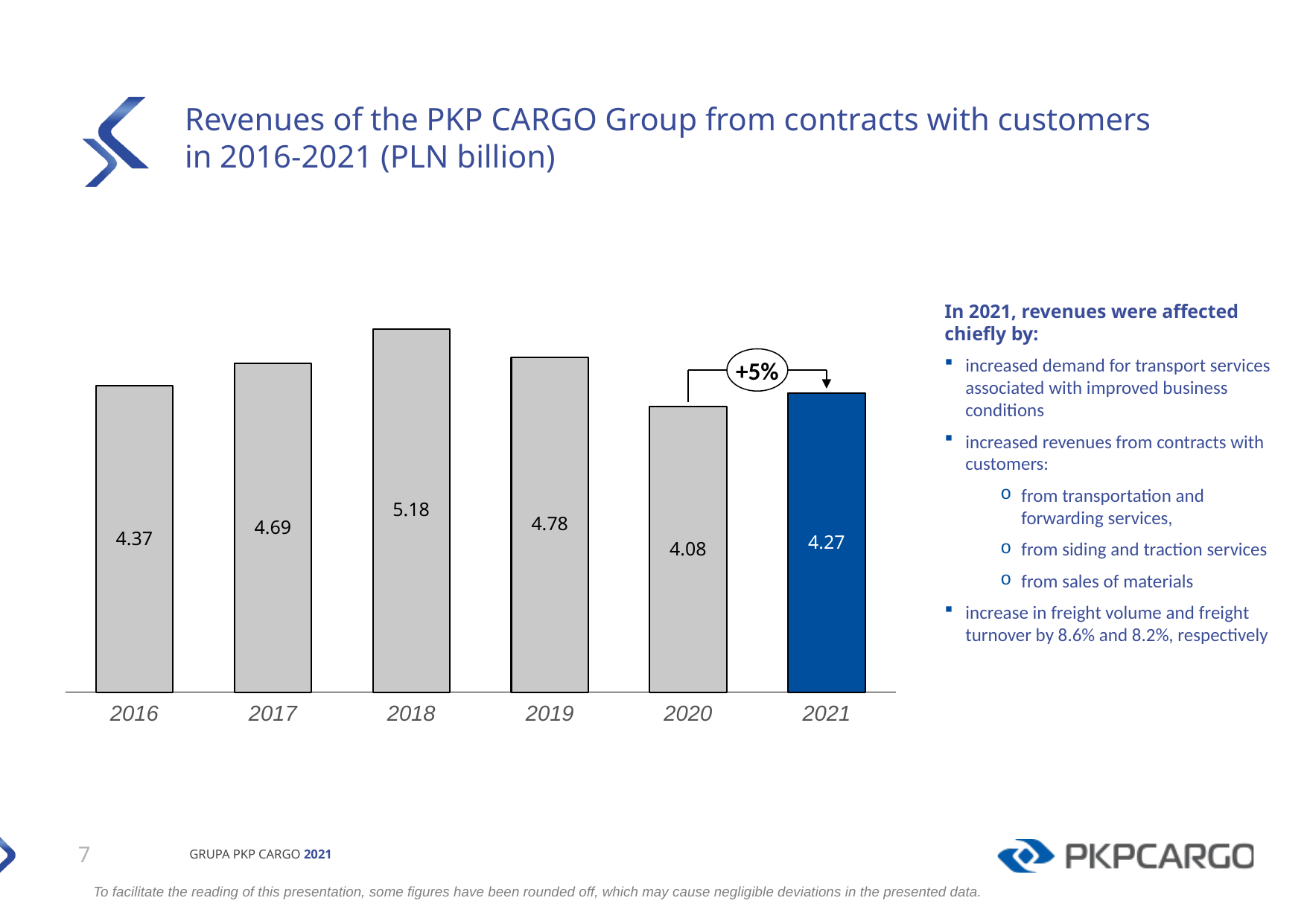
What was the revenue of the PKP CARGO Group from contracts with customers in 2021? 4.27 How many years are shown on the chart? 6 Which year had the lowest revenue from contracts with customers? 2020 Which year had higher revenue from contracts with customers, 2017 or 2019? 2019 Did revenue from contracts with customers rise or fall from 2018 to 2020? Fall What kind of chart is used to show the revenues? Bar chart By how much did revenue from contracts with customers change from 2020 to 2021 (in PLN billion)? 0.19 What was the revenue of the PKP CARGO Group from contracts with customers in 2018? 5.18 What is the difference between the 2018 and 2019 revenue values (in PLN billion)? 0.40 What was the revenue of the PKP CARGO Group from contracts with customers in 2016? 4.37 What percentage change is annotated between the 2020 and 2021 bars? +5% Which year had the highest revenue from contracts with customers? 2018